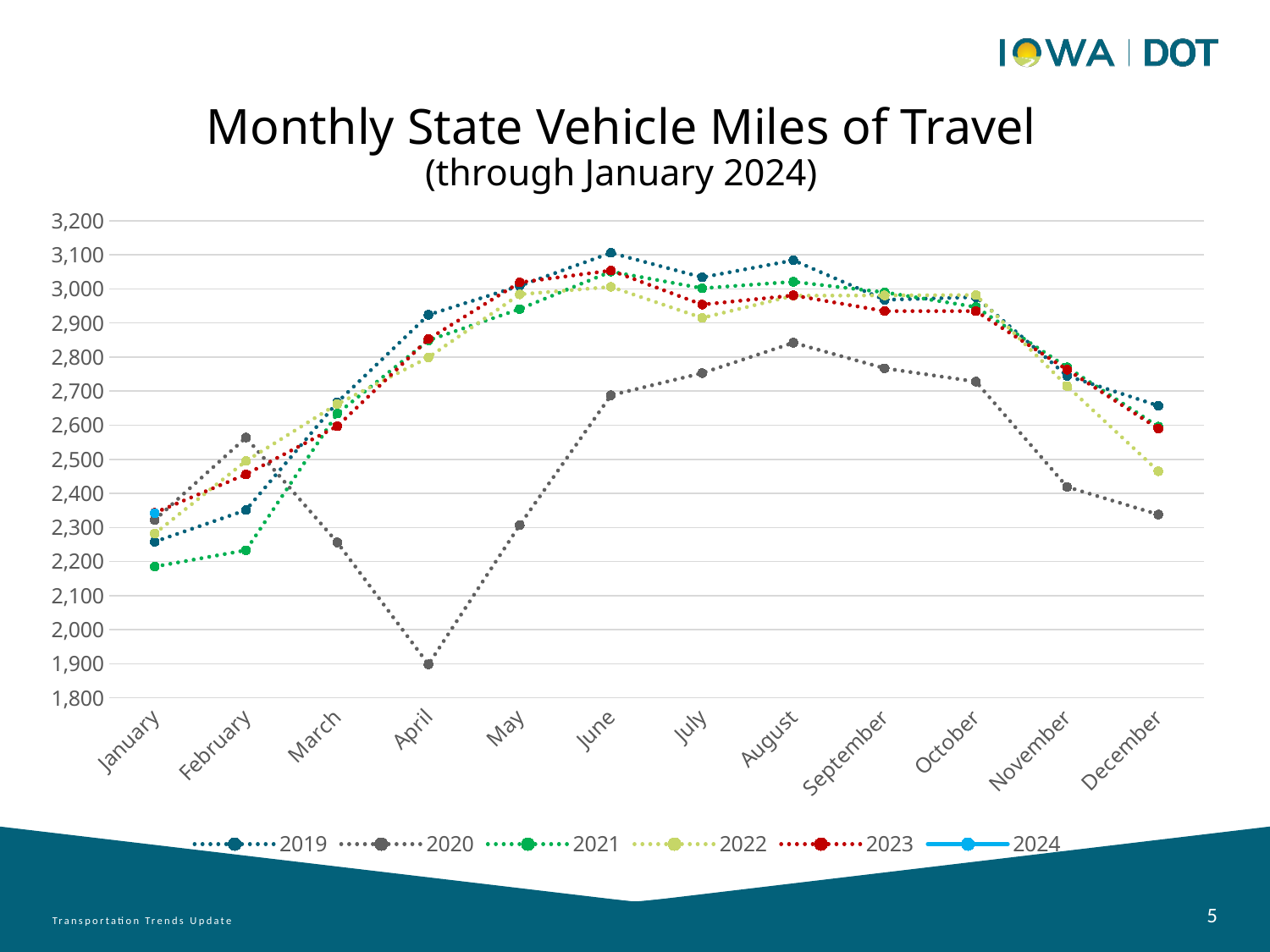
In which month does the 2020 series reach its highest value? August Does the 2020 series rise or fall from April to August? rise In which month does the 2020 series reach its lowest value? April How many months are shown along the x axis? 12 Is the value for 2022 in December greater or less than 2,500? less What kind of chart is shown on the slide? line chart Is the value for 2019 in June greater or less than 3,000? greater Is the value for 2020 in April greater or less than 2,000? less For the 2020 series, which is larger: the value in March or the value in April? March Which year's series has the lowest value in April? 2020 How many series does the legend list? 6 Which year's series has the highest value in June? 2019